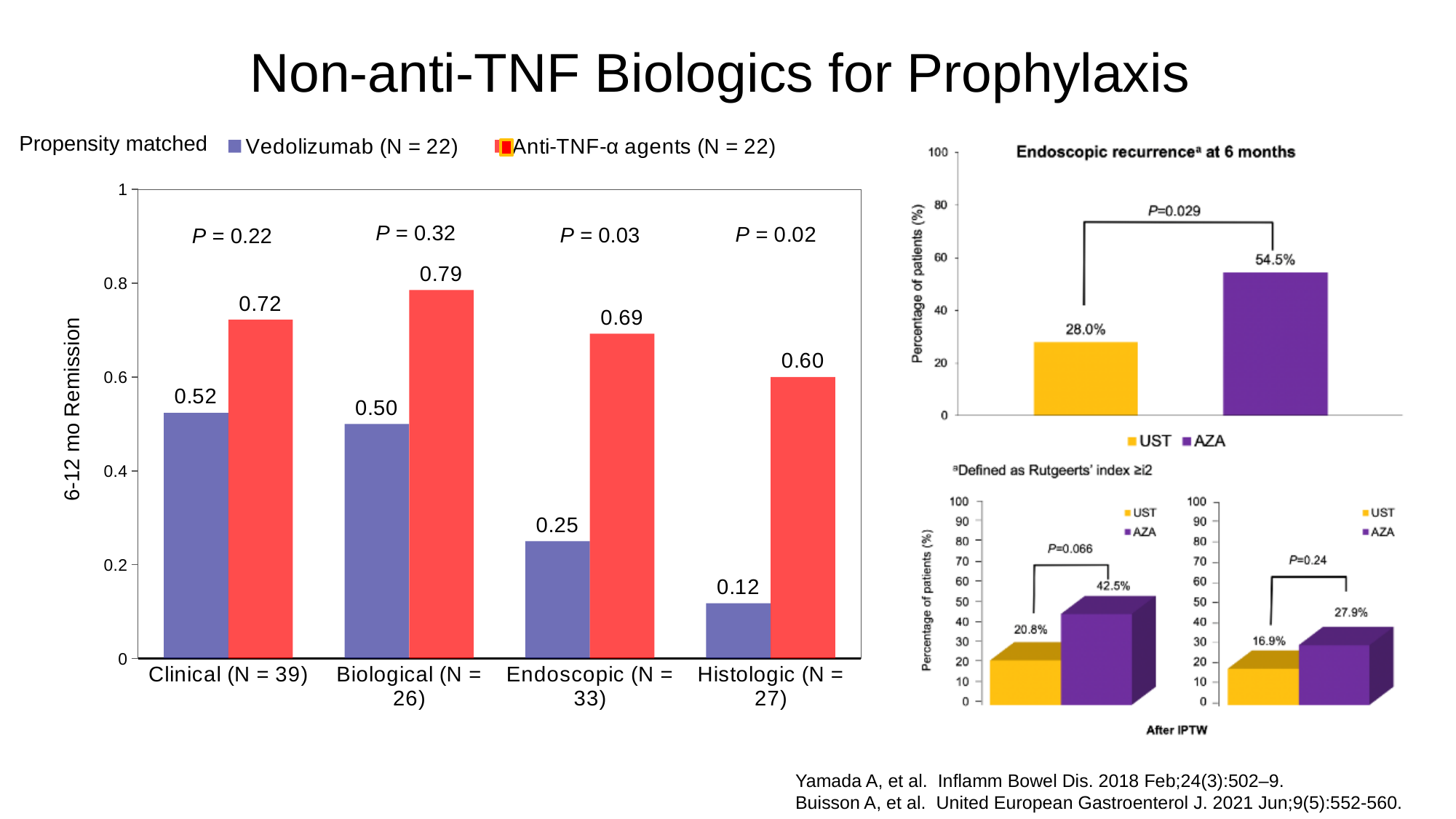
In the 'Endoscopic recurrence at 6 months' chart, what is the difference between the AZA and UST values? 26.5% In the left chart, which category has the highest Anti-TNF-α agents value? Biological (N = 26) In the left chart, what is the value for Anti-TNF-α agents in the Biological (N = 26) category? 0.79 How many categories are shown on the x axis of the left chart? 4 In the left chart, which category has the lowest Vedolizumab value? Histologic (N = 27) What kind of chart is the left chart? Bar chart In the 'Endoscopic recurrence at 6 months' chart, what is the value for AZA? 54.5% In the bottom-right 'After IPTW' chart on the far right, what is the value for UST? 16.9% In the left chart, what is the difference between the Anti-TNF-α agents and Vedolizumab values in the Endoscopic (N = 33) category? 0.44 In the left chart, what is the 6-12 mo remission value for Vedolizumab in the Clinical (N = 39) category? 0.52 In the left chart, which is larger in the Histologic (N = 27) category: Vedolizumab or Anti-TNF-α agents? Anti-TNF-α agents How many series does the legend of the left chart list? 2